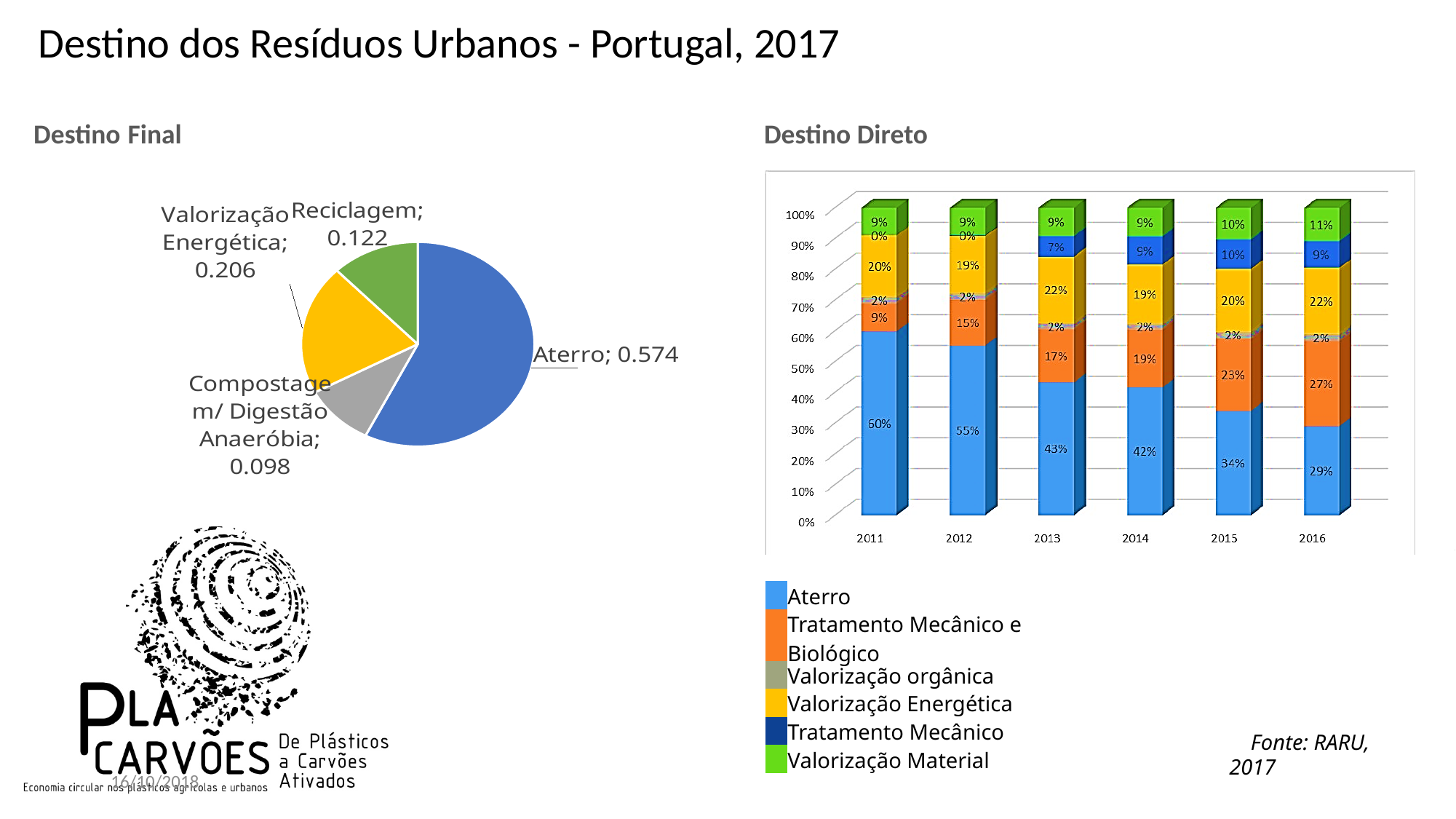
How many series does the legend of the Destino Direto chart list? 6 What kind of chart is the Destino Direto chart? stacked bar chart In the Destino Final pie chart, what is the value for Aterro? 0.574 How many slices does the Destino Final pie chart have? 4 In the Destino Final pie chart, what is the difference between the values for Valorização Energética and Reciclagem? 0.084 In the Destino Direto chart, does the Aterro share rise or fall from 2011 to 2016? fall In the Destino Direto chart, what is the difference between the Aterro percentages for 2011 and 2016? 31% In the Destino Direto chart, which year has the highest Aterro percentage? 2011 In the Destino Direto chart, what is the Tratamento Mecânico e Biológico percentage for 2014? 19% In the Destino Final pie chart, what is the value for Reciclagem? 0.122 In the Destino Direto chart, what is the Aterro percentage for 2016? 29% In the Destino Final pie chart, which category has the smallest slice? Compostagem/ Digestão Anaeróbia